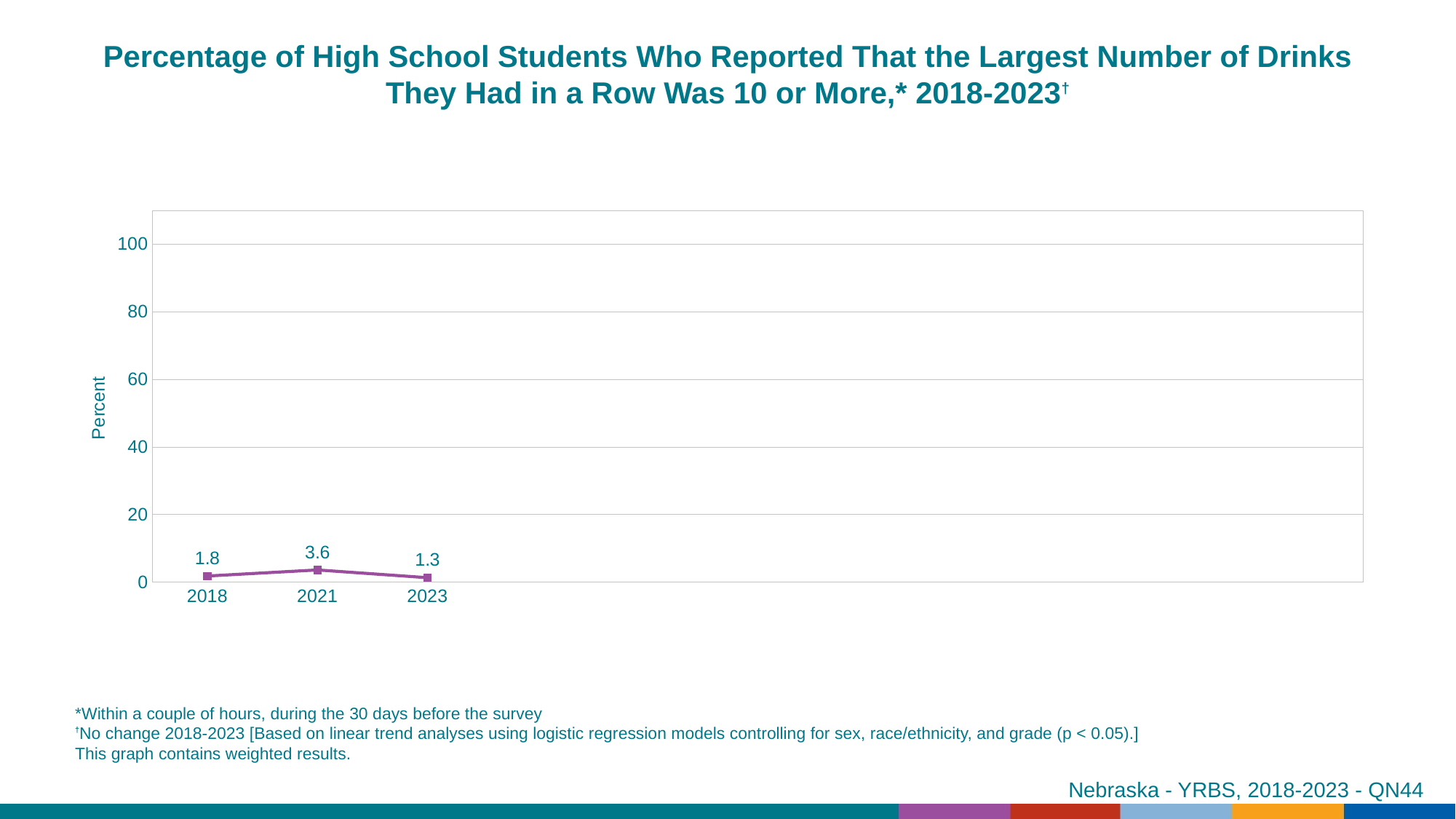
What is the value for 2021? 3.6 Which year has the highest value? 2021 Which is larger, the value for 2018 or the value for 2023? 2018 What is the value for 2018? 1.8 What is the difference between the values for 2021 and 2018? 1.8 Which year has the lowest value? 2023 Is the value for 2021 greater or less than 20? less What is the difference between the values for 2021 and 2023? 2.3 What kind of chart is shown on the slide? line chart How many years are plotted on the chart? 3 What is the value for 2023? 1.3 What is the label of the y axis? Percent